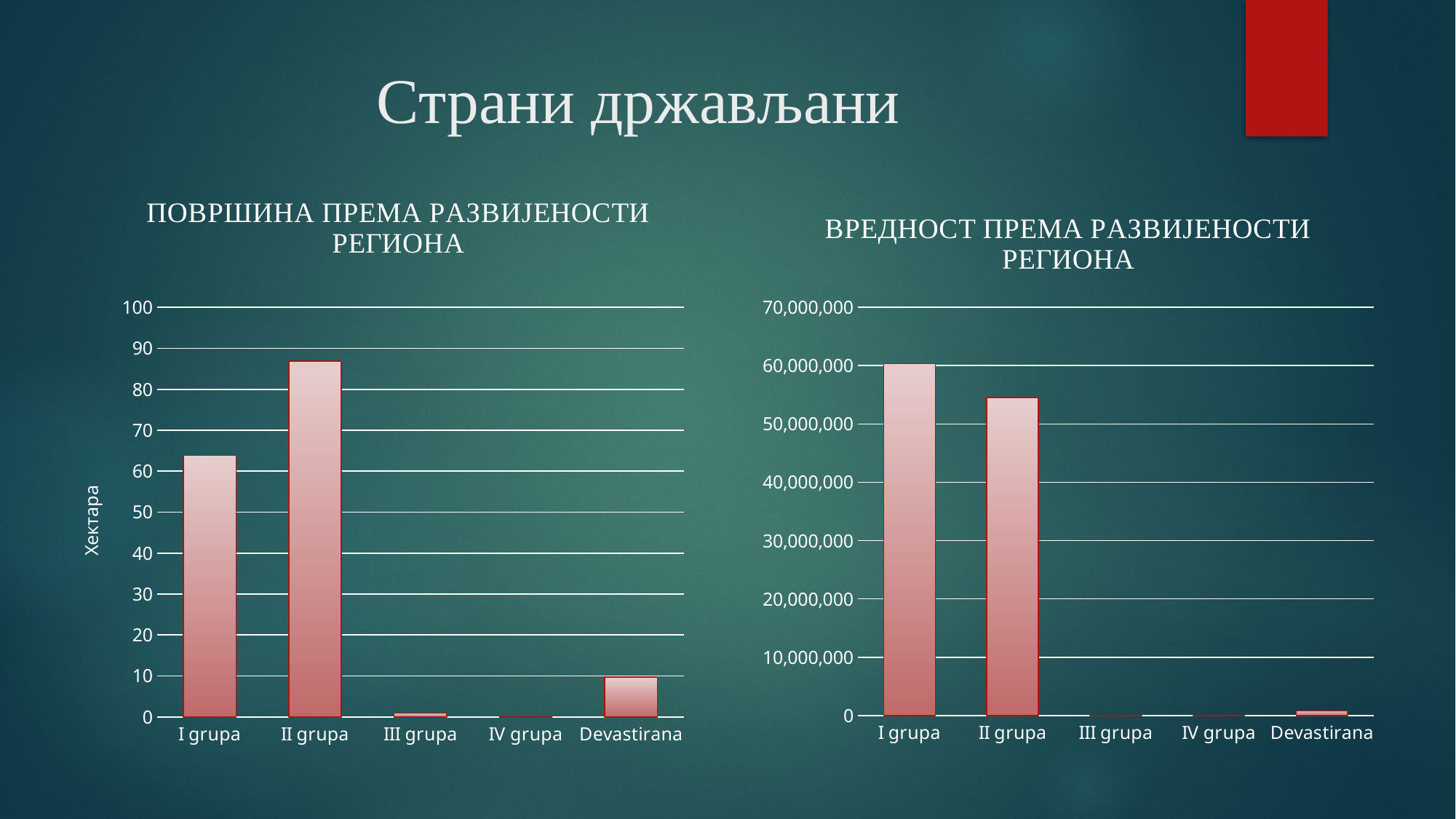
In the right chart (ВРЕДНОСТ ПРЕМА РАЗВИЈЕНОСТИ РЕГИОНА), which category has the highest value? I grupa What kind of chart is the left chart, ПОВРШИНА ПРЕМА РАЗВИЈЕНОСТИ РЕГИОНА? Bar chart In the left chart (ПОВРШИНА ПРЕМА РАЗВИЈЕНОСТИ РЕГИОНА), which category has the highest value? II grupa In the left chart (ПОВРШИНА ПРЕМА РАЗВИЈЕНОСТИ РЕГИОНА), is the value for II grupa greater or less than 80? greater In the left chart (ПОВРШИНА ПРЕМА РАЗВИЈЕНОСТИ РЕГИОНА), is the value for Devastirana greater or less than 20? less How many categories are shown on the x axis of the left chart (ПОВРШИНА ПРЕМА РАЗВИЈЕНОСТИ РЕГИОНА)? 5 In the left chart (ПОВРШИНА ПРЕМА РАЗВИЈЕНОСТИ РЕГИОНА), which is larger, I grupa or II grupa? II grupa In the right chart (ВРЕДНОСТ ПРЕМА РАЗВИЈЕНОСТИ РЕГИОНА), is the value for I grupa greater or less than 50,000,000? greater In the right chart (ВРЕДНОСТ ПРЕМА РАЗВИЈЕНОСТИ РЕГИОНА), which is larger, I grupa or II grupa? I grupa